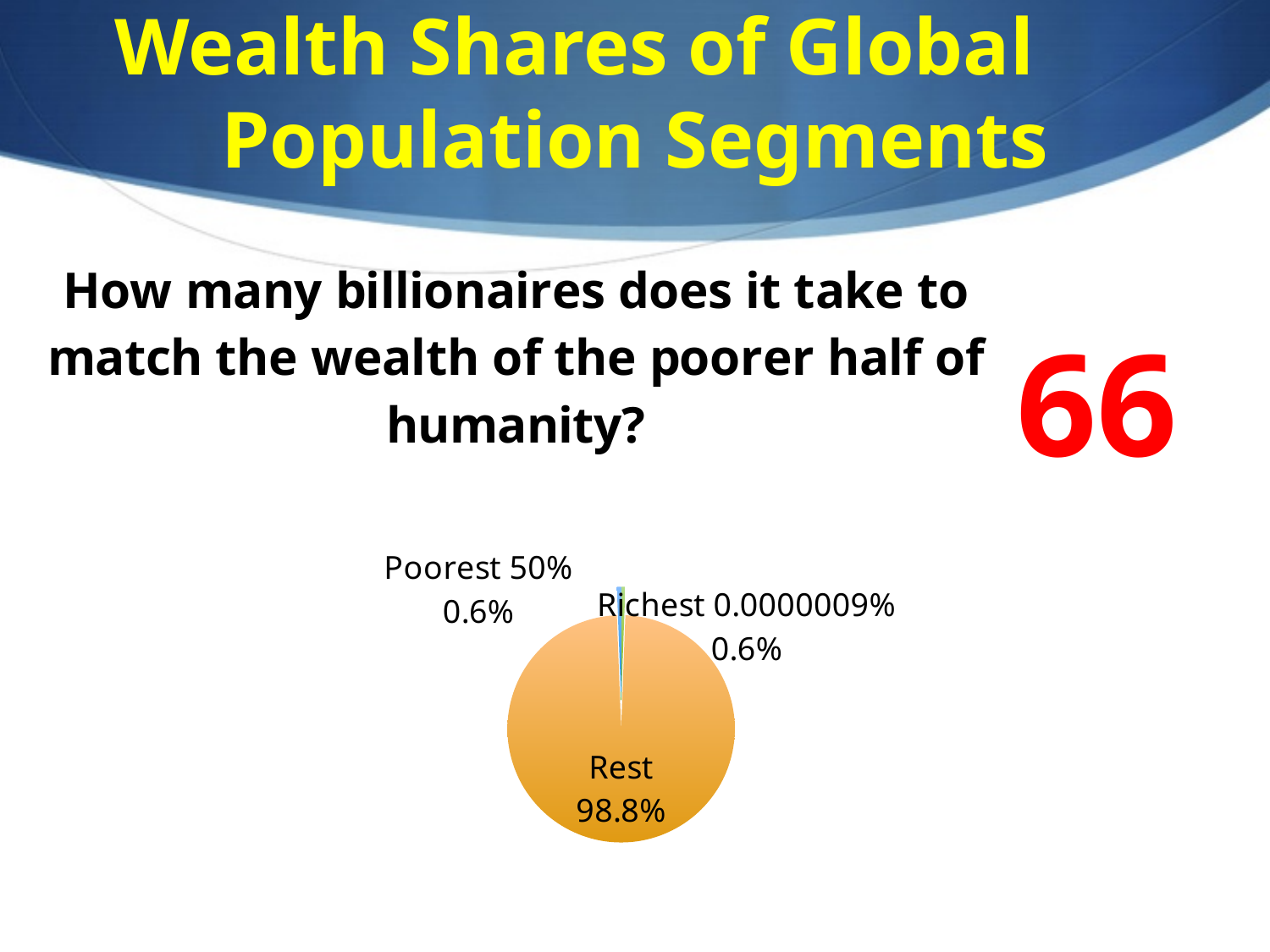
What kind of chart is shown on the slide? pie chart What colour is the 'Rest' slice of the pie chart? orange Which is larger, the share for 'Rest' or the share for 'Poorest 50%'? Rest What is the wealth share shown for the 'Poorest 50%' slice? 0.6% Which slice of the pie chart is the largest? Rest Do the 'Poorest 50%' and 'Richest 0.0000009%' slices have the same share? Yes, both 0.6% What is the difference between the 'Rest' share and the 'Poorest 50%' share? 98.2% What is the title of the slide containing the pie chart? Wealth Shares of Global Population Segments What is the combined share of the 'Poorest 50%' and 'Richest 0.0000009%' slices? 1.2% How many slices does the pie chart have? 3 What share of wealth does the 'Rest' slice represent? 98.8% What is the wealth share shown for the 'Richest 0.0000009%' slice? 0.6%